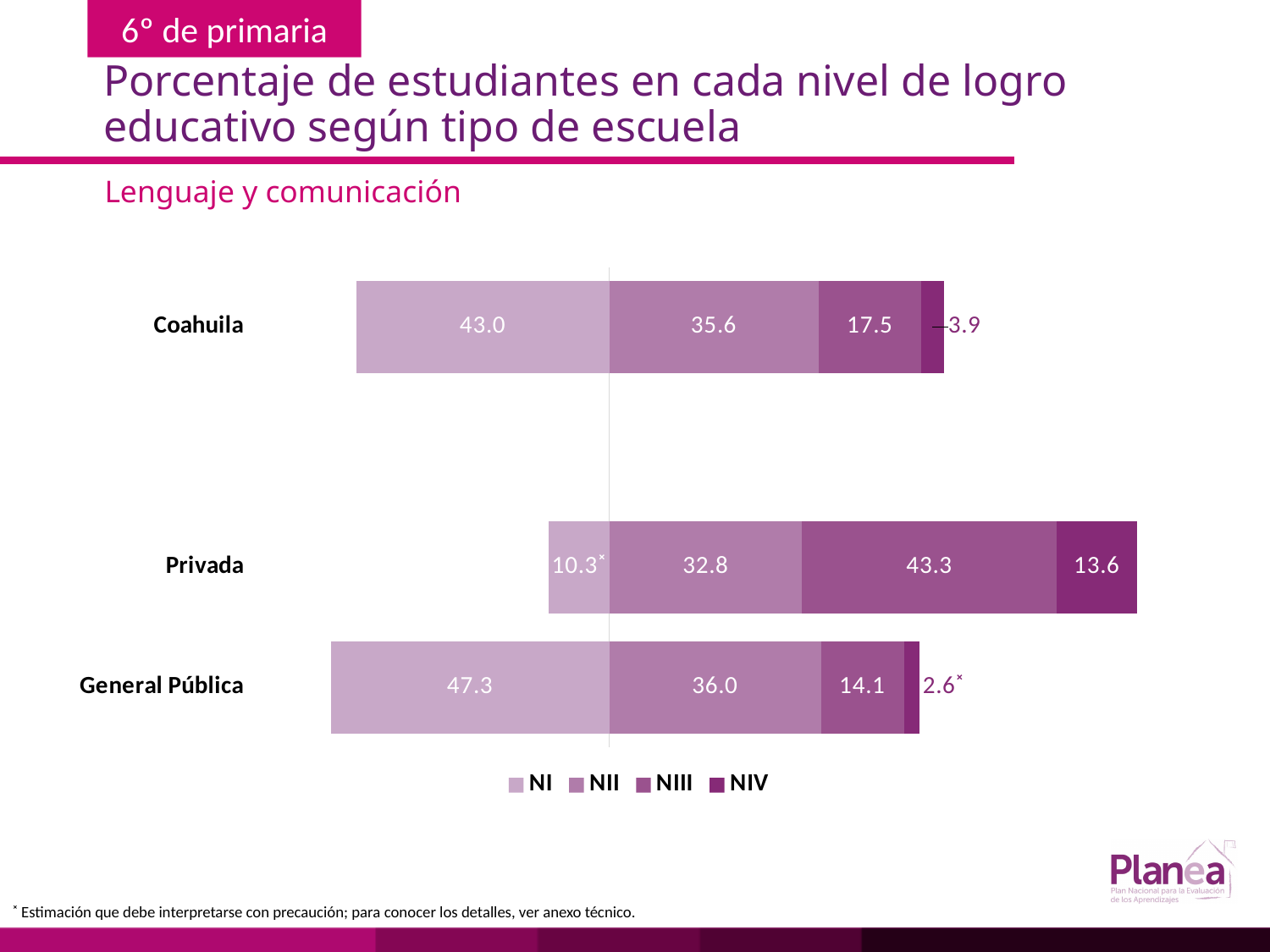
What is the NIII value for Privada? 43.3 What is the NIV value for General Pública? 2.6 How many school types (categories) are shown in the chart? 3 What type of chart is shown on the slide? Stacked bar chart Which school type has the highest NI value? General Pública What is the NI value for Coahuila? 43.0 What is the difference between the NIII values for Privada and Coahuila? 25.8 How many series does the legend list? 4 What is the total of the stacked bar for Privada? 100.0 What is the NII value for General Pública? 36.0 Which is larger, the NII value for Coahuila or the NII value for Privada? Coahuila Which school type has the lowest NIV value? General Pública